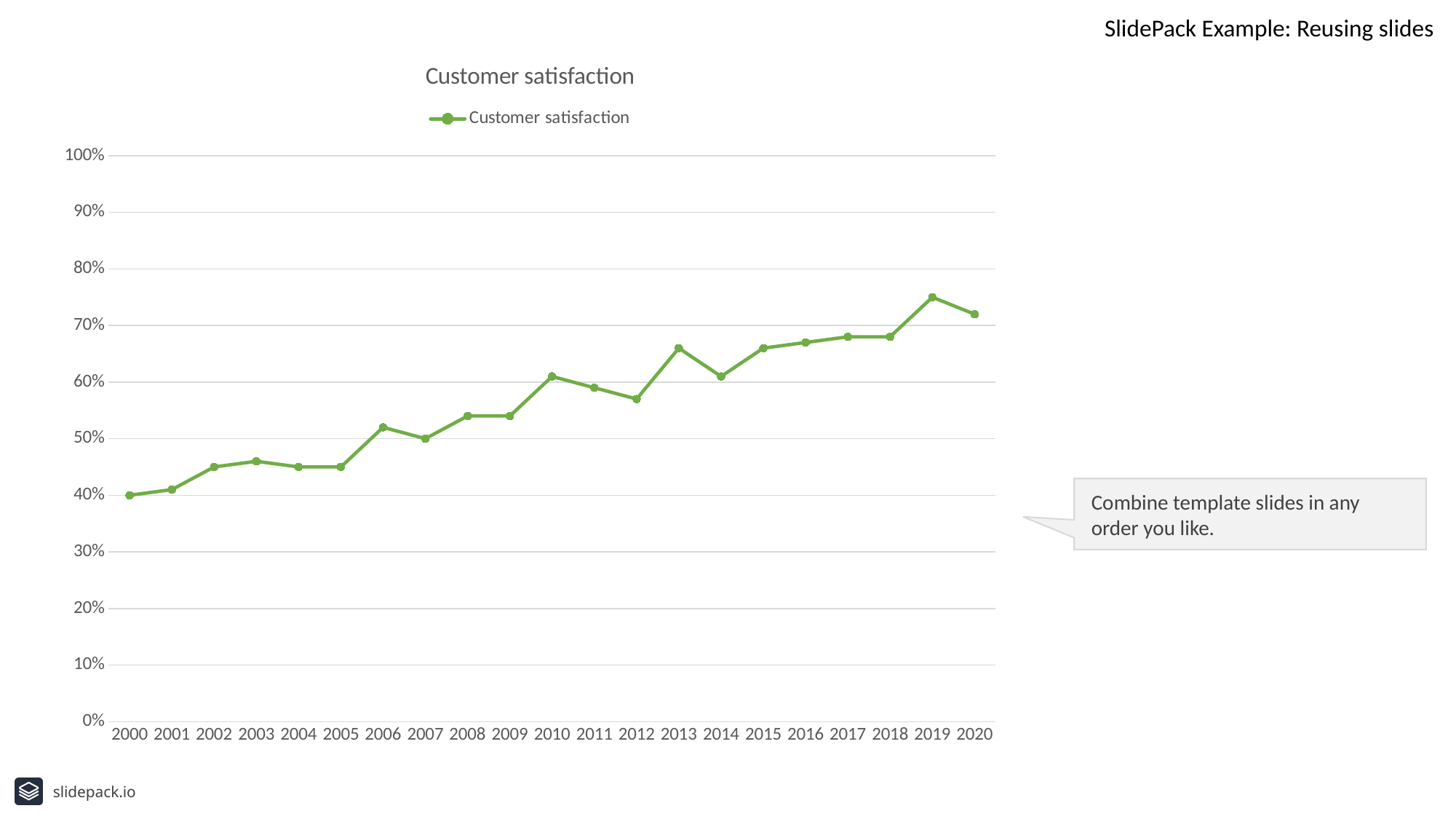
How many years are plotted along the x axis? 21 Which year has the highest customer satisfaction value? 2019 What is the customer satisfaction value for 2000? 40% Is the value for 2003 greater or less than 50%? less Overall, do the values rise or fall from 2000 to 2020? rise Which year has the larger value, 2013 or 2014? 2013 How many series does the legend list? 1 What type of chart is shown on the slide? line chart What is the title of the chart? Customer satisfaction Which year has the lowest customer satisfaction value? 2000 Is the value for 2012 greater or less than 60%? less Is the value for 2019 greater or less than 70%? greater